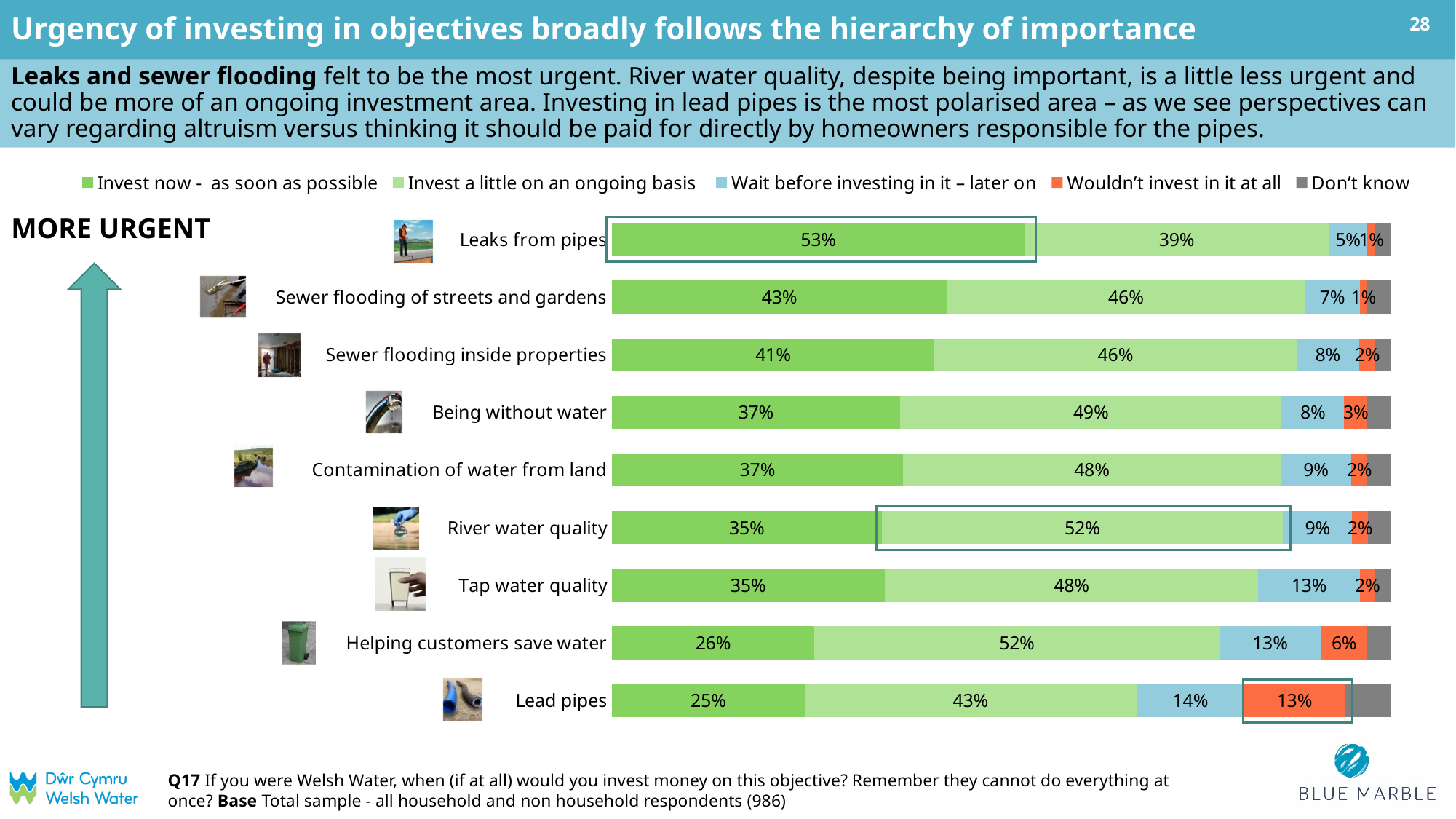
What is the difference between the 'Invest now - as soon as possible' values for Leaks from pipes and Sewer flooding of streets and gardens? 10 percentage points What is the 'Invest a little on an ongoing basis' value for River water quality? 52% How many objectives are shown in the chart? 9 Which objective has the highest 'Invest now - as soon as possible' percentage? Leaks from pipes What percentage of respondents said 'Invest now - as soon as possible' for Leaks from pipes? 53% Which colour represents 'Wouldn't invest in it at all' in the chart? Orange How many series does the legend list? 5 What type of chart is shown on the slide? Stacked bar chart What is the 'Wait before investing in it – later on' value for Tap water quality? 13% Which objective has the lowest 'Invest now - as soon as possible' percentage? Lead pipes Which is larger: the 'Wouldn't invest in it at all' value for Lead pipes or for Helping customers save water? Lead pipes What is the 'Wouldn't invest in it at all' value for Lead pipes? 13%